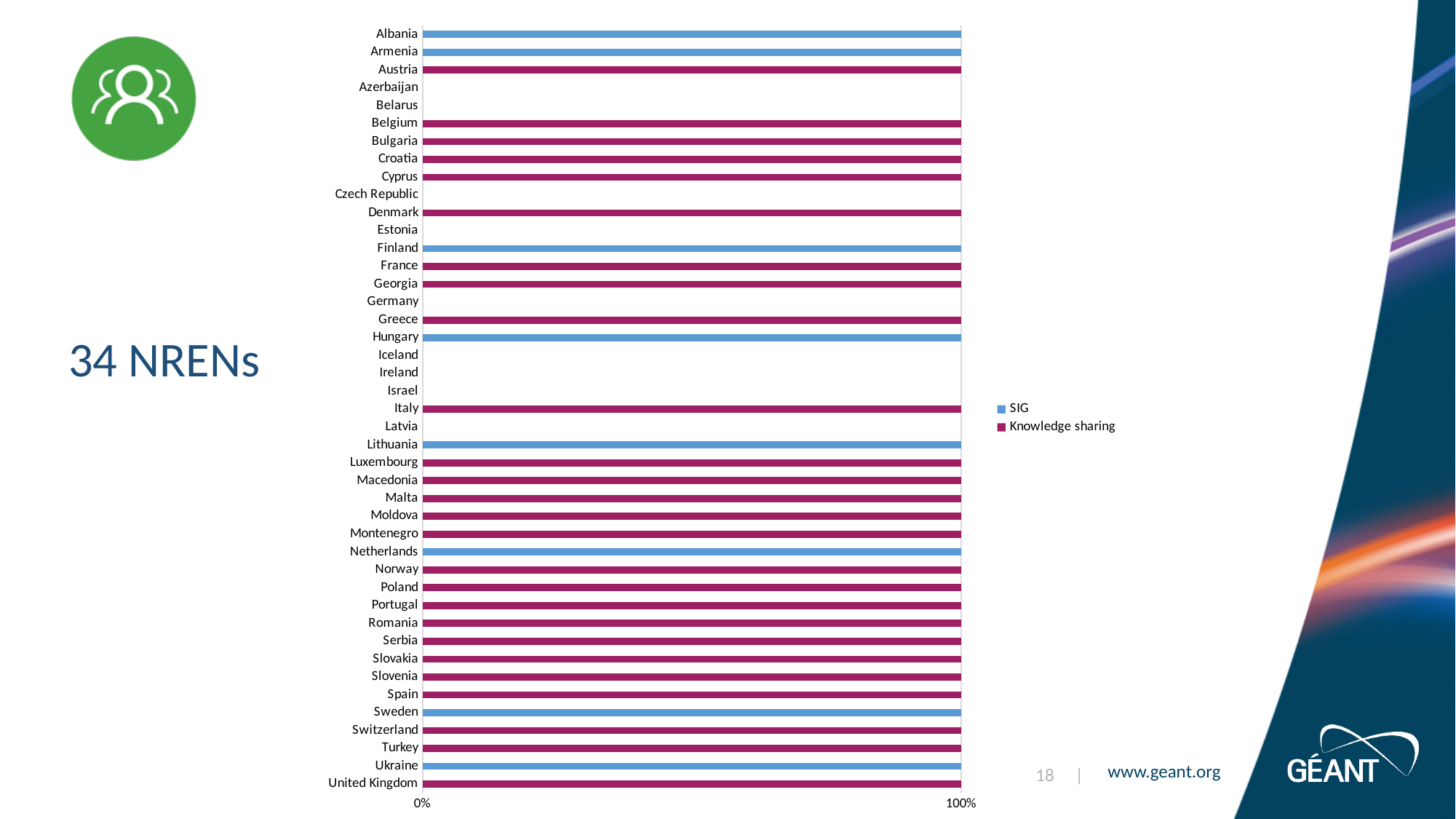
Which series does the bar for Albania belong to? SIG What are the two series named in the chart legend? SIG and Knowledge sharing Which series does the bar for United Kingdom belong to? Knowledge sharing How many series does the chart legend list? 2 How many countries have a SIG bar on the chart? 8 What is the SIG value shown for Finland? 100% What is the maximum value shown on the chart's horizontal axis? 100% How many countries have no bar at all on the chart? 9 What is the Knowledge sharing value shown for Austria? 100% What colour represents the Knowledge sharing series in the chart? magenta How many countries are listed on the chart's vertical axis? 43 What kind of chart is shown on the slide? bar chart